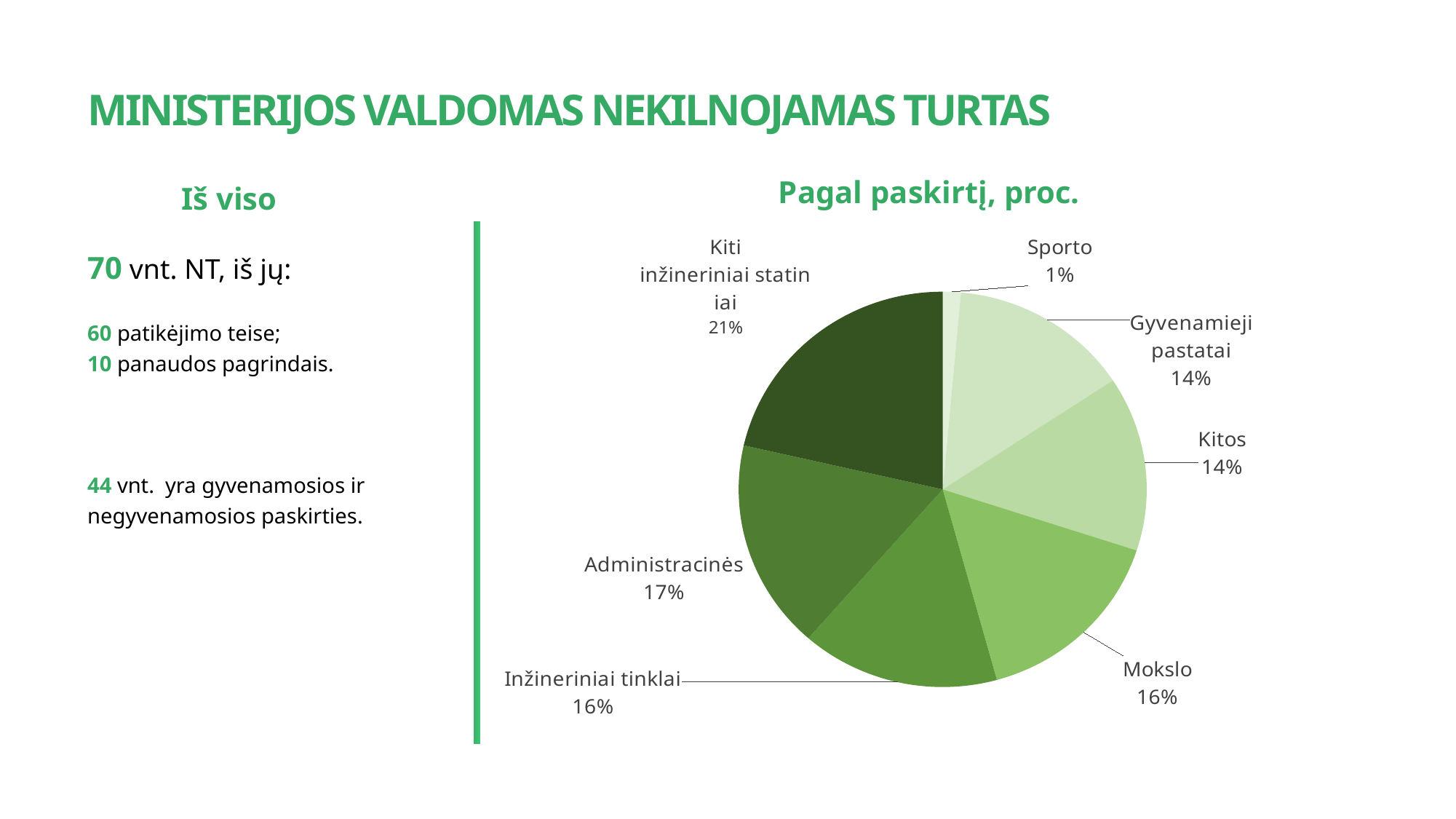
What is the value shown for "Sporto"? 1% What is the value shown for "Gyvenamieji pastatai"? 14% What is the title of the pie chart? Pagal paskirtį, proc. What share of the pie does "Kiti inžineriniai statiniai" hold? 21% What kind of chart is shown under the title "Pagal paskirtį, proc."? pie chart What is the difference in percentage points between "Inžineriniai tinklai" and "Sporto"? 15 Which category has the smallest slice of the pie? Sporto How many categories are shown in the pie chart? 7 Which is larger, the slice for "Mokslo" or the slice for "Kitos"? Mokslo What is the difference in percentage points between "Kiti inžineriniai statiniai" and "Administracinės"? 4 What is the value shown for "Administracinės"? 17% Which category has the largest slice of the pie? Kiti inžineriniai statiniai